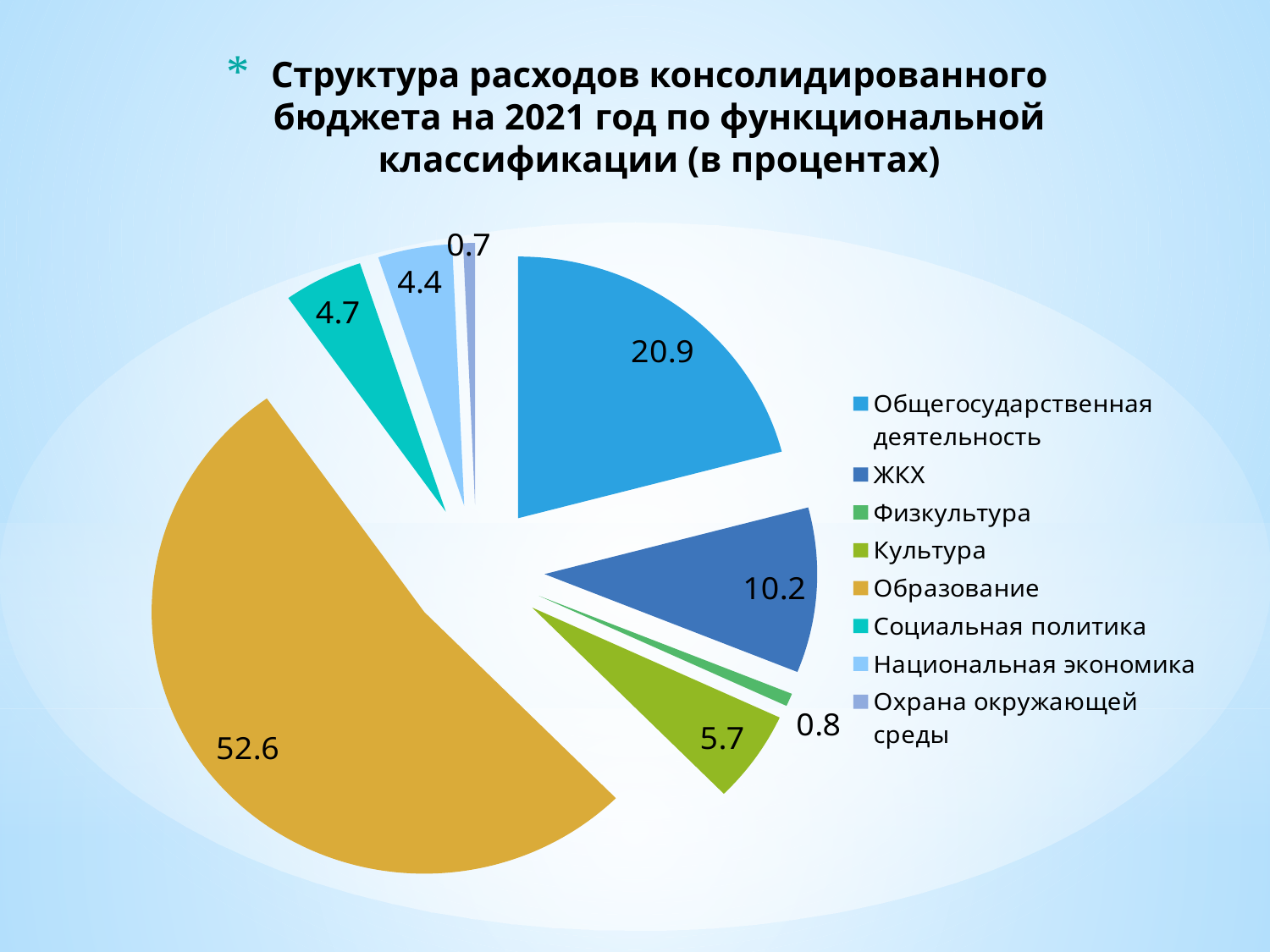
What is the title of the chart? Структура расходов консолидированного бюджета на 2021 год по функциональной классификации (в процентах) What is the value for ЖКХ? 10.2 How many categories does the pie chart have? 8 What is the value for Общегосударственная деятельность? 20.9 What type of chart is shown on the slide? pie chart Which category has the largest share of the pie? Образование What is the difference between the values for Образование and Общегосударственная деятельность? 31.7 What is the value for Образование? 52.6 What is the value for Охрана окружающей среды? 0.7 What is the value for Культура? 5.7 Which category has the smallest share of the pie? Охрана окружающей среды Which is larger, the value for Общегосударственная деятельность or the value for ЖКХ? Общегосударственная деятельность